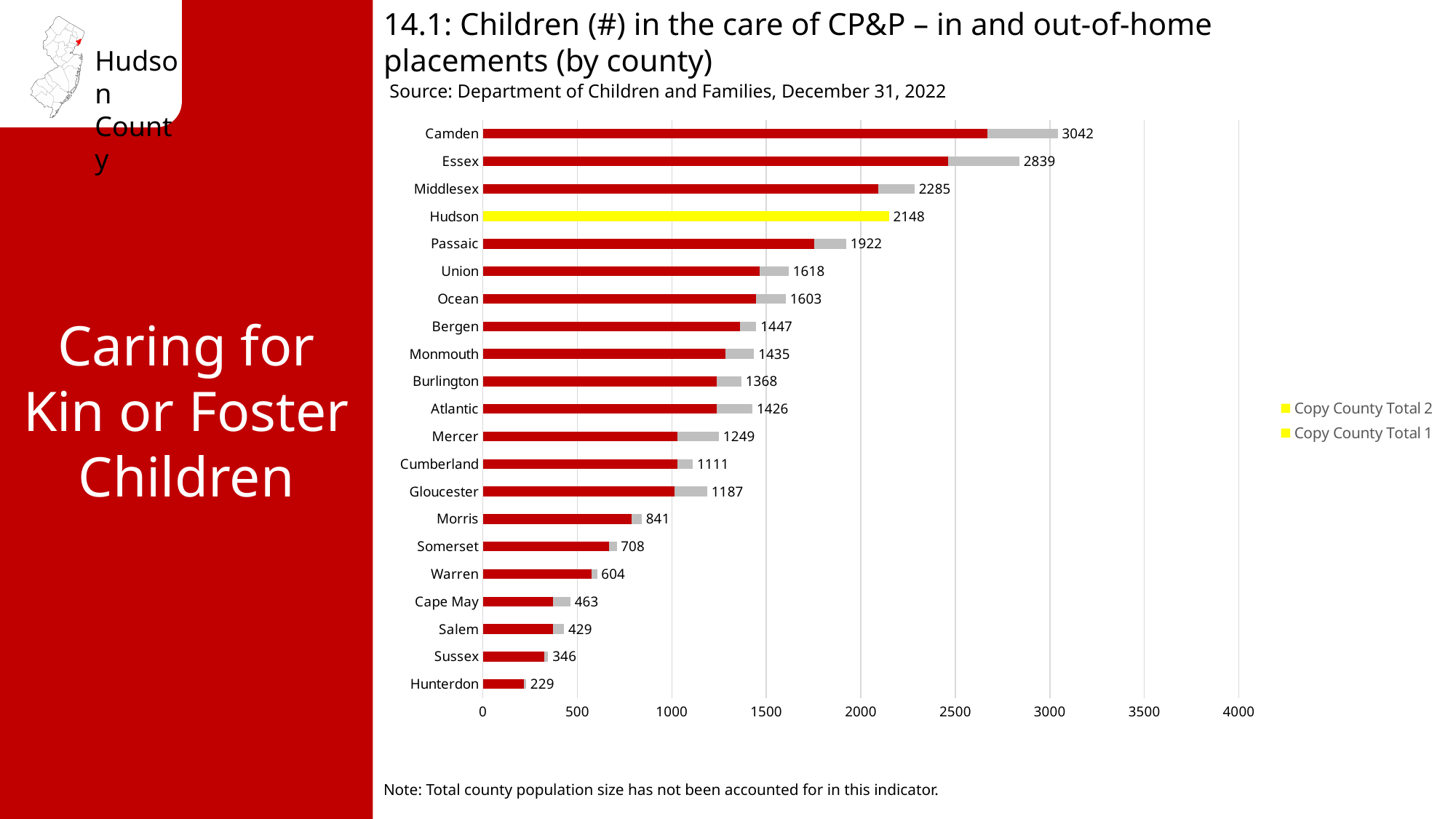
How many series does the legend list? 2 What is the total value shown for Hudson? 2148 What kind of chart is shown on the slide? Bar chart What is the total value shown for Hunterdon? 229 Which county has the highest total? Camden Which has a larger total, Gloucester or Cumberland? Gloucester Which county has the lowest total? Hunterdon What is the difference between the totals for Hudson and Passaic? 226 Which has a larger total, Atlantic or Burlington? Atlantic What is the difference between the totals for Camden and Essex? 203 How many counties are shown on the chart? 21 What is the total number of children in the care of CP&P for Camden? 3042